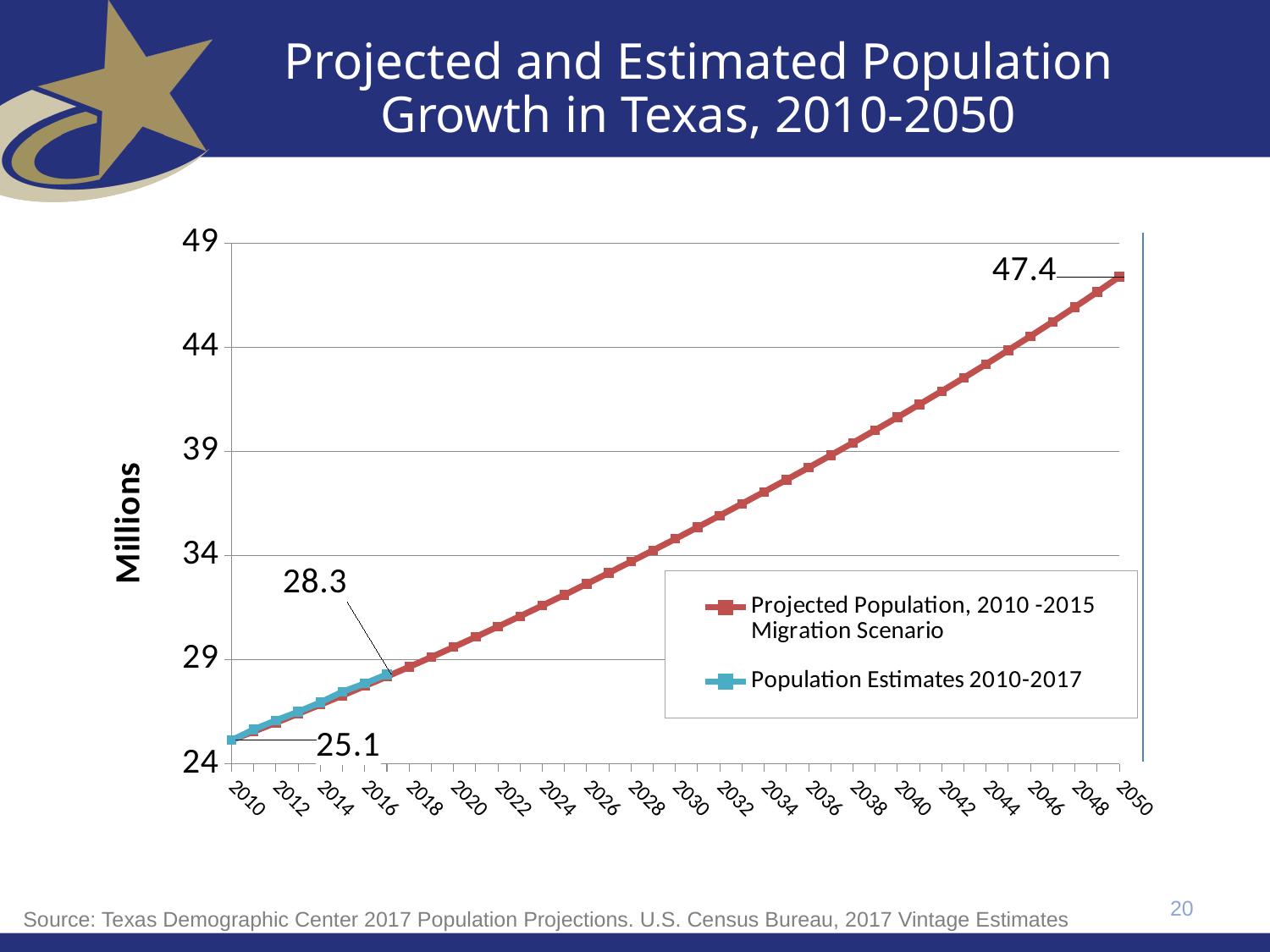
What is the difference between the labelled 2050 value (47.4) and the labelled 2010 value (25.1)? 22.3 How many series does the legend list? 2 What value is labelled at the start of the Population Estimates series in 2010? 25.1 What is the projected population for Texas in 2050 according to the chart? 47.4 What kind of chart is shown on the slide? line chart What value is labelled at the end of the Population Estimates series in 2017? 28.3 Do the plotted values rise or fall from 2010 to 2050? rise Is the projected population value for 2030 greater or less than 34? greater Which year has the highest plotted value on the chart? 2050 What is the title of the vertical axis? Millions By how much does the labelled 2017 estimate (28.3) exceed the labelled 2010 value (25.1)? 3.2 Is the projected population value for 2040 greater or less than 39? greater